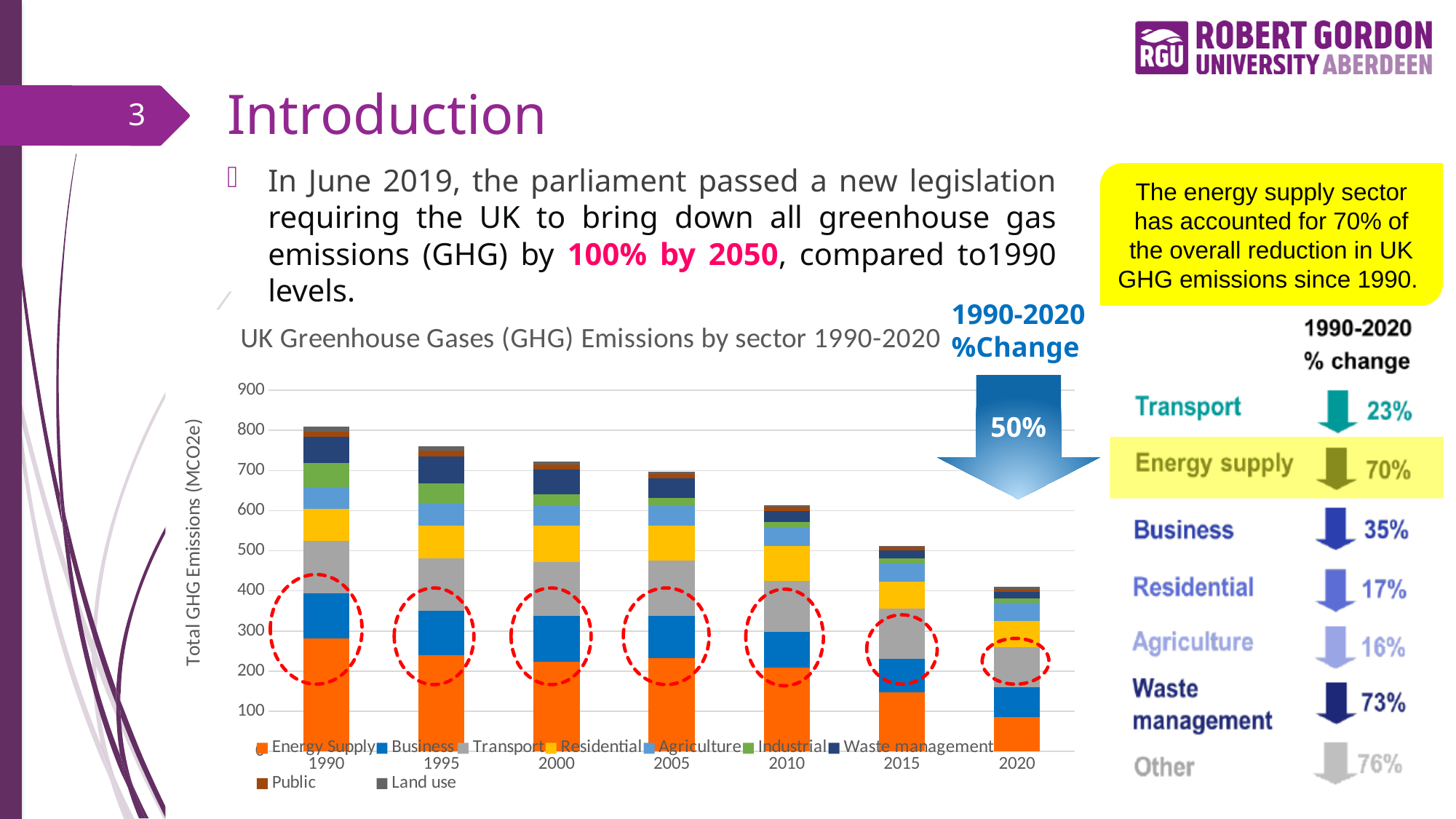
Is the total GHG emissions value for 2010 greater or less than 500? greater How many series does the legend of the GHG emissions chart list? 9 What type of chart is used to show UK Greenhouse Gases (GHG) Emissions by sector 1990-2020? Stacked bar chart Is the total GHG emissions value for 1990 greater or less than 700? greater Is the total GHG emissions value for 2020 greater or less than 500? less Which year has the lowest total GHG emissions in the chart? 2020 Do total GHG emissions rise or fall from 1990 to 2020 in the chart? Fall Which year has the larger total GHG emissions, 1995 or 2015? 1995 How many years (categories) are shown on the x axis of the GHG emissions chart? 7 What is the label on the vertical axis of the GHG emissions chart? Total GHG Emissions (MCO2e) What is the title of the chart on the slide? UK Greenhouse Gases (GHG) Emissions by sector 1990-2020 Which year has the highest total GHG emissions in the chart? 1990